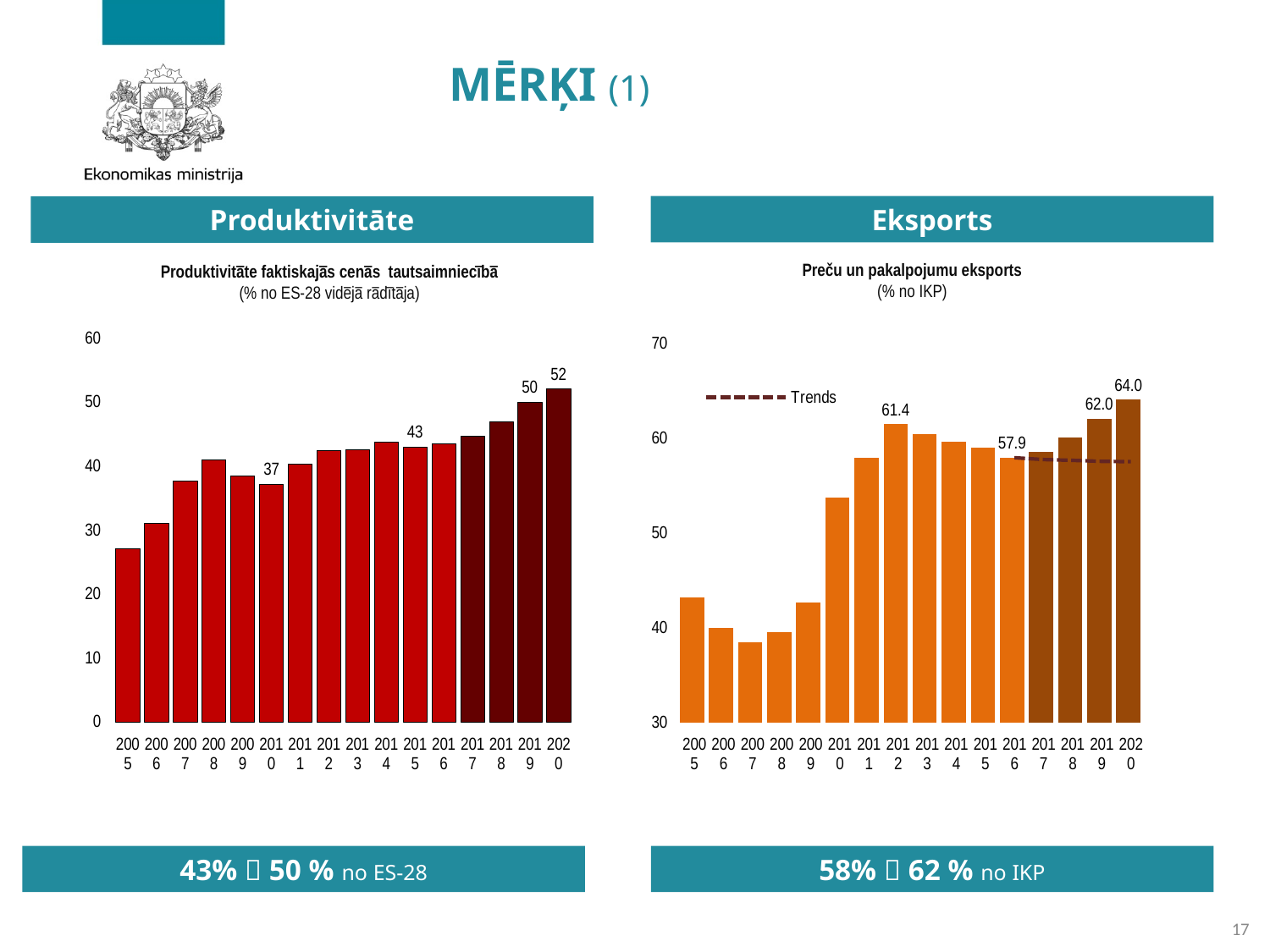
In the Preču un pakalpojumu eksports chart, what is the difference between the 2020 and 2019 values? 2.0 In the Produktivitāte chart, what is the value for 2015? 43 In the Produktivitāte chart, what is the value for 2020? 52 In the Preču un pakalpojumu eksports chart, what is the value for 2016? 57.9 In the Produktivitāte chart, what is the difference between the 2020 and 2015 values? 9 In the Produktivitāte chart, is the value for 2005 greater or less than 30? less In the Prečuun pakalpojumu eksports chart, what is the value for 2012? 61.4 In the Produktivitāte chart, how many years are shown on the x axis? 16 In the Produktivitāte chart, which year has the lowest value? 2005 In the Produktivitāte chart, what is the value for 2010? 37 In the Preču un pakalpojumu eksports chart, is the value for 2007 greater or less than 40? less In the Preču un pakalpojumu eksports chart, which year has the highest value? 2020